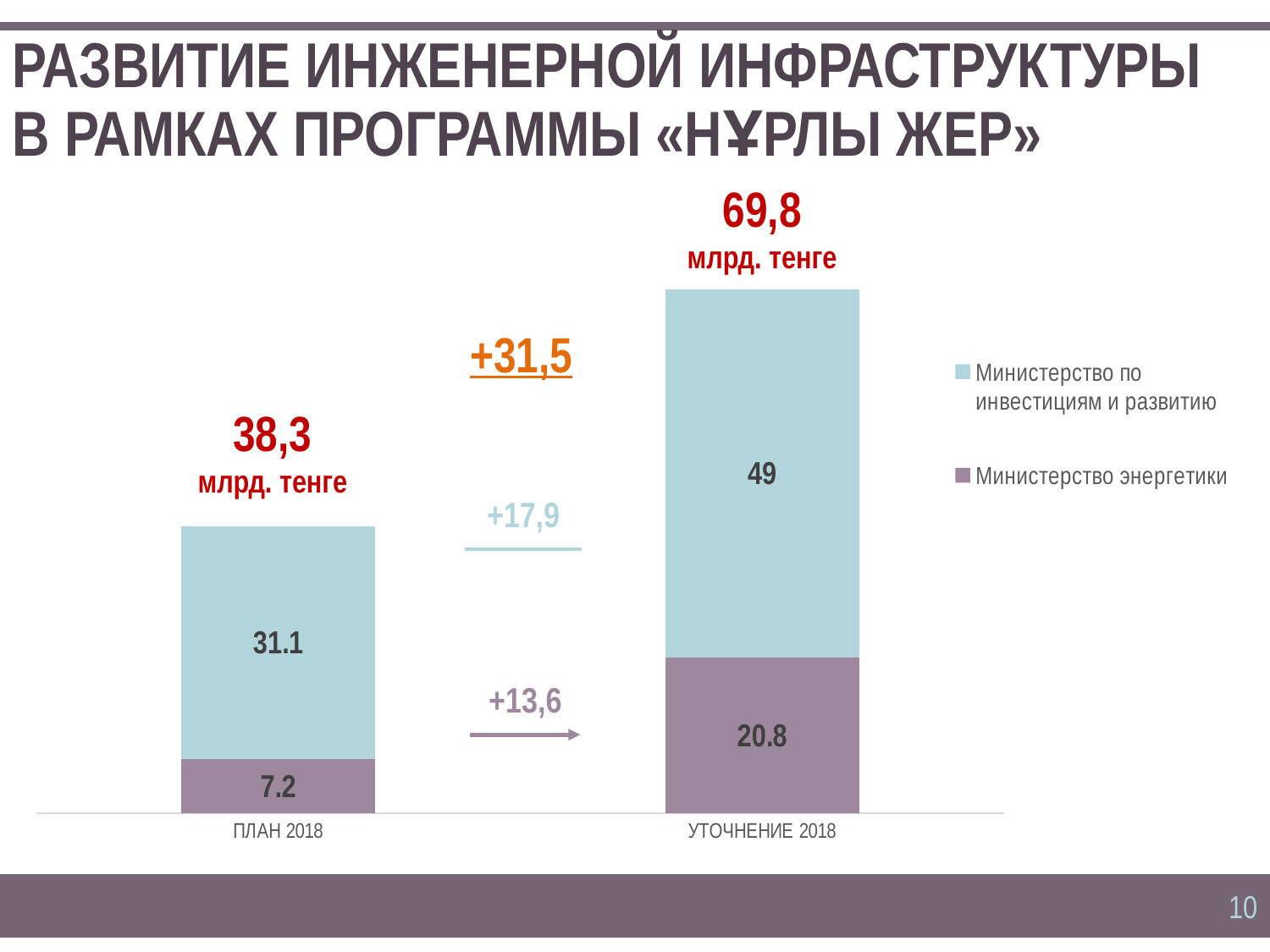
What is the value for Министерство энергетики in УТОЧНЕНИЕ 2018? 20.8 What is the total of the stacked bar for ПЛАН 2018? 38,3 млрд. тенге Which category has the higher total, ПЛАН 2018 or УТОЧНЕНИЕ 2018? УТОЧНЕНИЕ 2018 What kind of chart is shown on the slide? Stacked bar chart What is the total of the stacked bar for УТОЧНЕНИЕ 2018? 69,8 млрд. тенге How many series does the legend list? 2 What is the value for Министерство по инвестициям и развитию in ПЛАН 2018? 31.1 What is the value for Министерство по инвестициям и развитию in УТОЧНЕНИЕ 2018? 49 By how much does the Министерство энергетики value increase from ПЛАН 2018 to УТОЧНЕНИЕ 2018? +13,6 How many categories are shown on the x axis? 2 What is the value for Министерство энергетики in ПЛАН 2018? 7.2 By how much does the Министерство по инвестициям и развитию value increase from ПЛАН 2018 to УТОЧНЕНИЕ 2018? +17,9